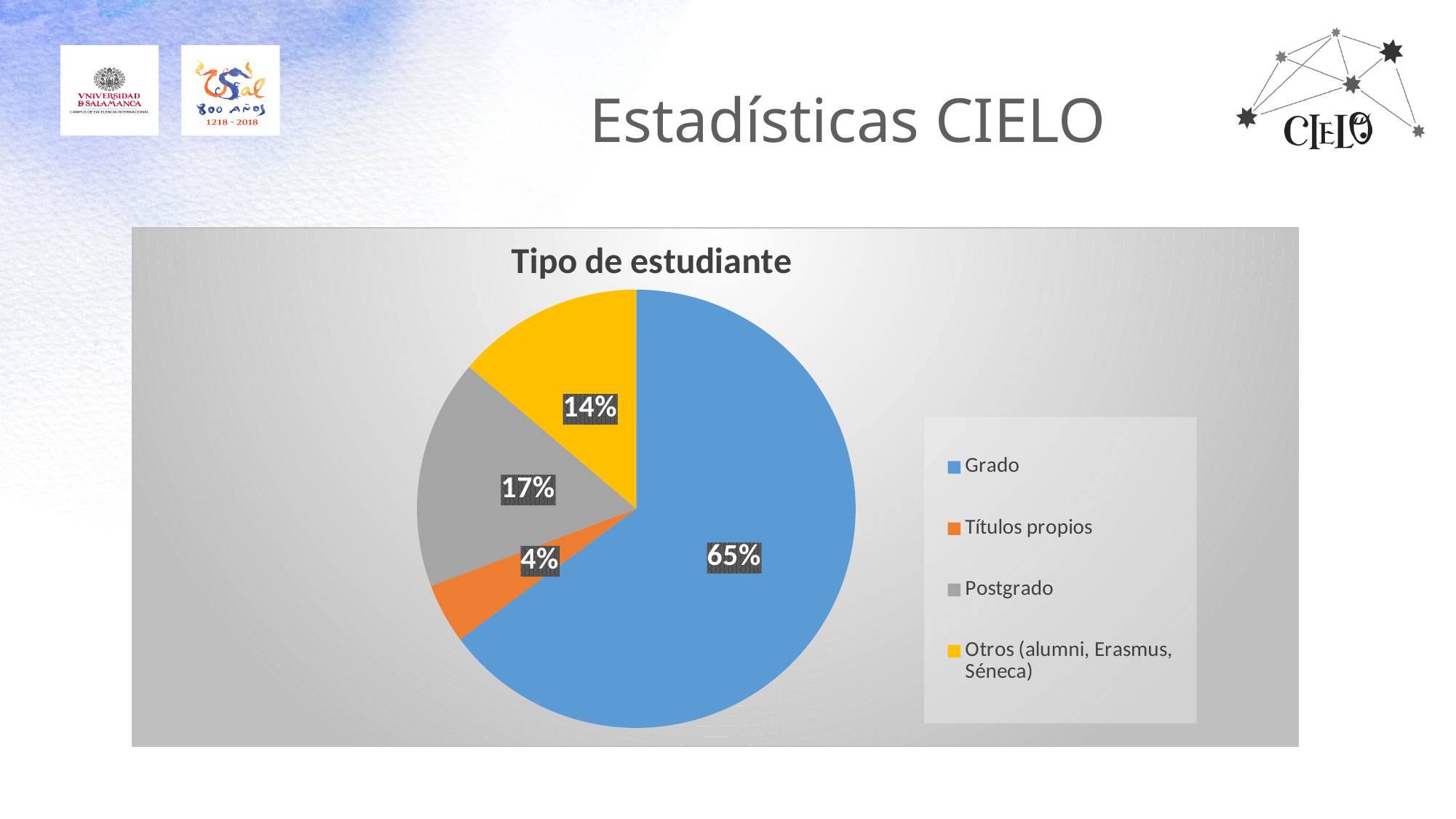
What share of the pie does Otros (alumni, Erasmus, Séneca) represent? 14% What share of the pie does Postgrado represent? 17% Which category has the largest slice of the pie? Grado What share of the pie does Títulos propios represent? 4% Which category has the smallest slice of the pie? Títulos propios How many categories does the pie chart show? 4 What colour is the slice for Otros (alumni, Erasmus, Séneca)? yellow Which is larger, the share for Postgrado or the share for Otros (alumni, Erasmus, Séneca)? Postgrado What is the title of the chart? Tipo de estudiante What type of chart is shown on the slide? pie chart What is the difference in percentage points between Grado and Postgrado? 48